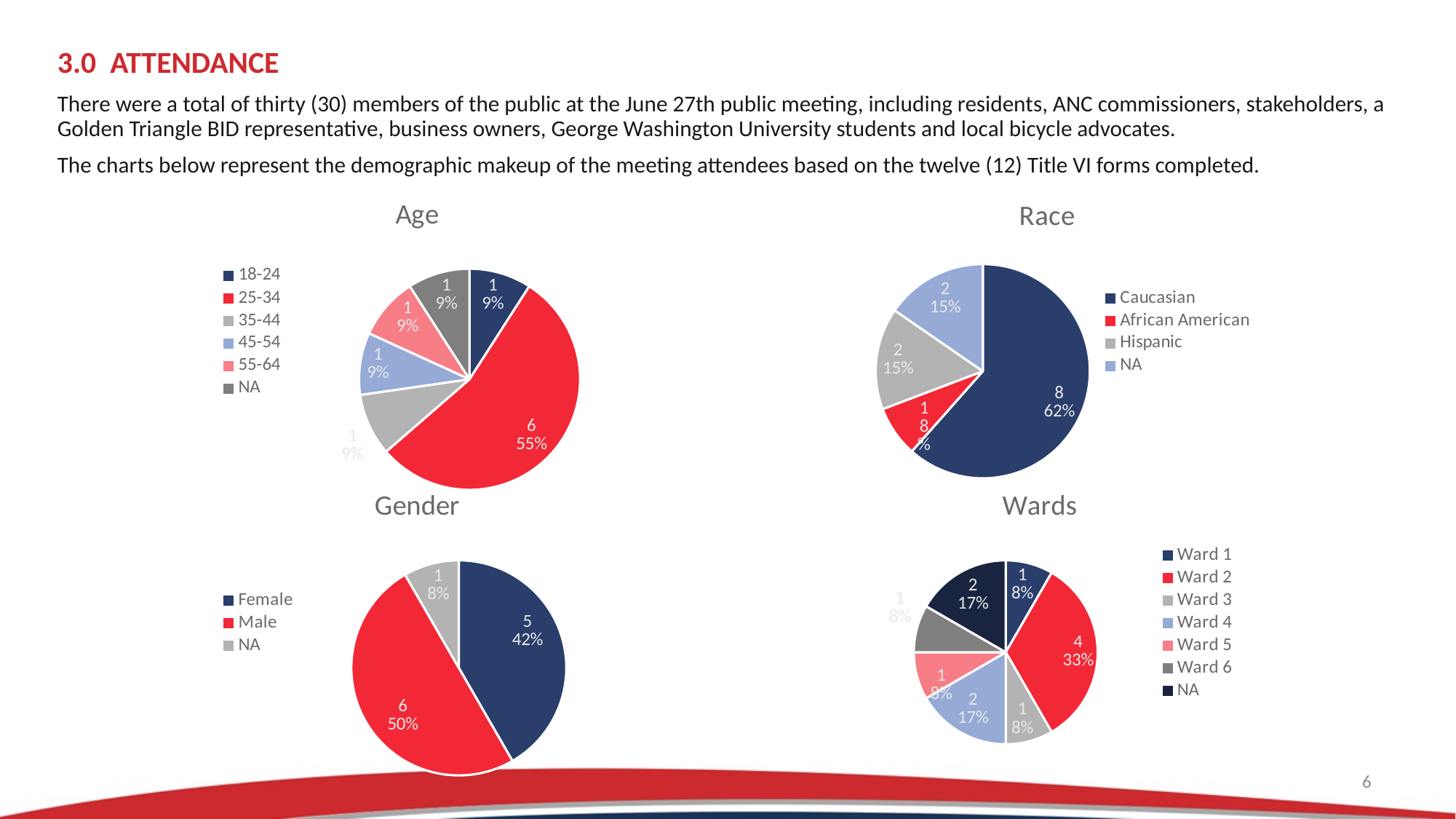
In the Race chart, what share of attendees are Caucasian? 62% In the Race chart, which category has the smallest slice? African American In the Age chart, what share of attendees are in the 25-34 group? 55% In the Wards chart, what share of attendees are from Ward 2? 33% How many categories does the Age chart's legend list? 6 In the Gender chart, how many attendees are Male? 6 What type of chart is the Wards chart? Pie chart In the Wards chart, what is the difference in count between Ward 2 and Ward 4? 2 In the Race chart, how many attendees are Hispanic? 2 In the Gender chart, which is larger, Male or Female? Male In the Age chart, which age group has the largest slice? 25-34